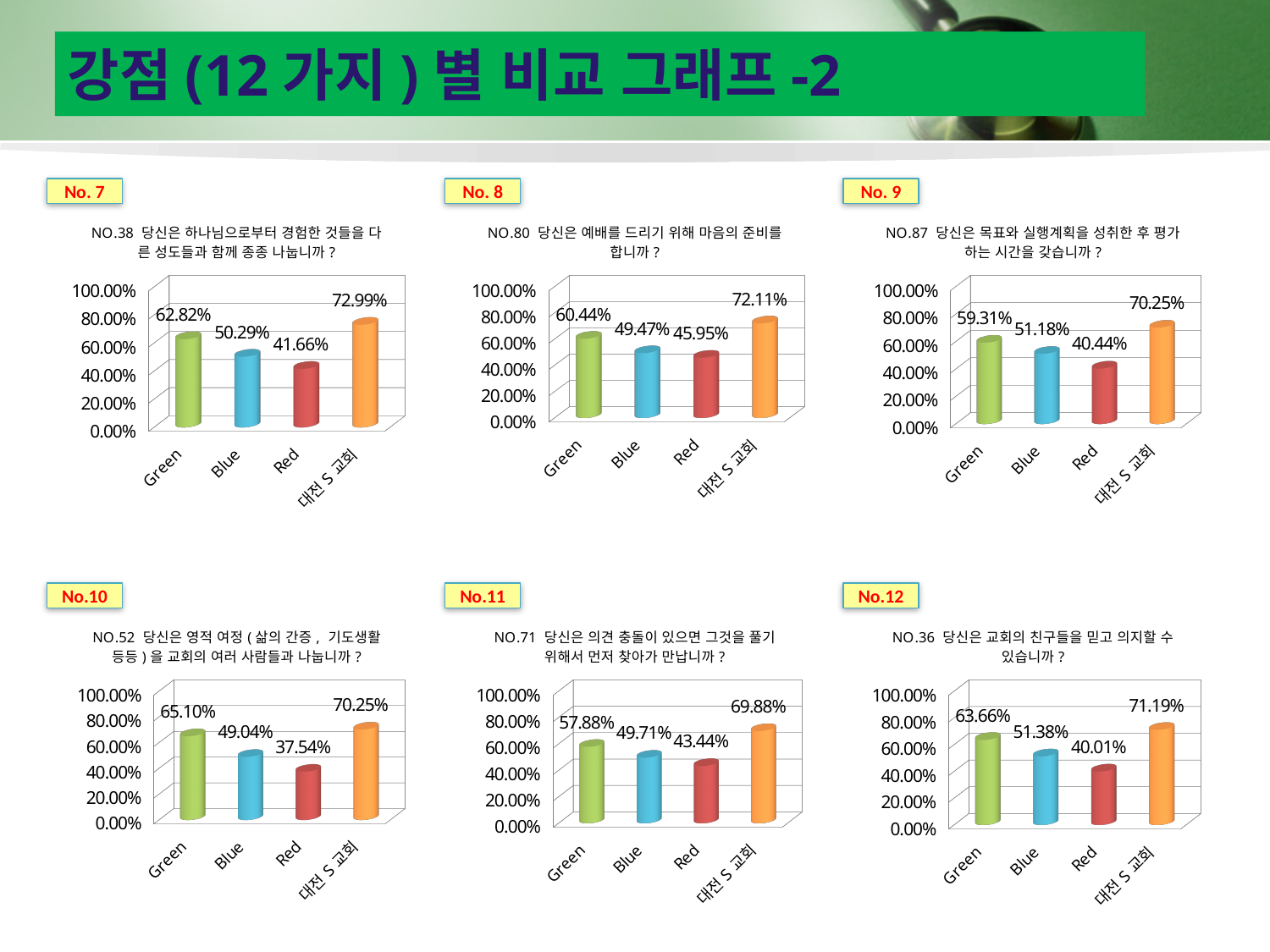
In the No.10 chart, what is the difference between the values for 대전 S 교회 and Red? 32.71% What kind of chart is the No. 8 chart? bar chart In the No.11 chart, which is larger, the value for Green or the value for Blue? Green In the No. 9 chart, is the value for Blue greater or less than 60.00%? less In the No. 8 chart, which category has the highest value? 대전 S 교회 In the No.12 chart, what is the value for 대전 S 교회? 71.19% In the No.11 chart, what is the value for Red? 43.44% In the No. 7 chart, what is the value for Green? 62.82% How many categories are shown on the x axis of the No. 7 chart? 4 In the No. 9 chart, which category has the lowest value? Red How many charts are shown on the slide? 6 In the No.12 chart, what is the difference between the values for Green and Blue? 12.28%